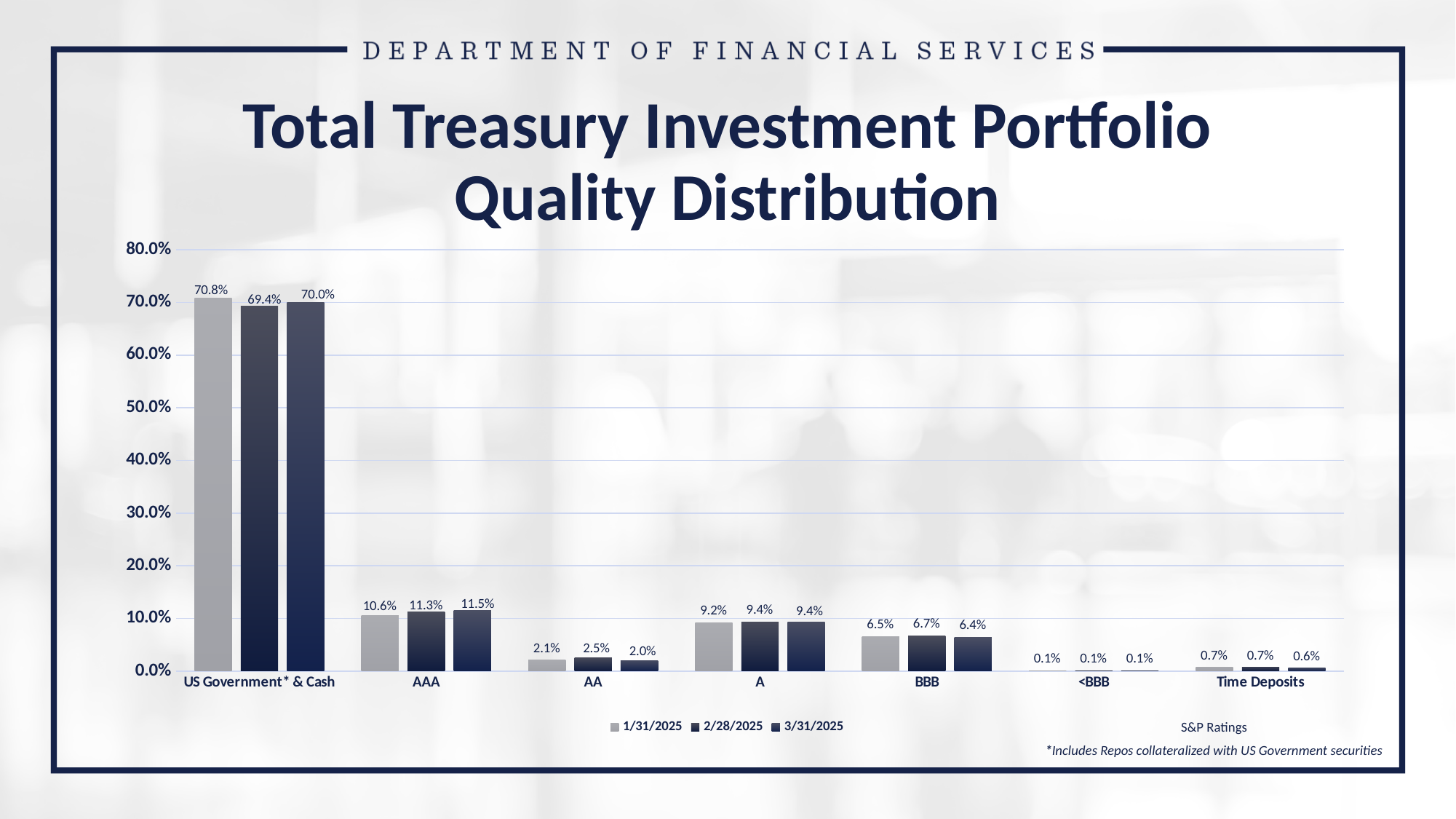
Which category has the highest value on 3/31/2025? US Government* & Cash What is the value for AAA on 3/31/2025? 11.5% Is the value for AAA on 1/31/2025 greater or less than 10.0%? greater What kind of chart is shown on the slide? Bar chart Which is larger for BBB: the 2/28/2025 value or the 3/31/2025 value? 2/28/2025 How many categories are shown on the x axis? 7 What is the value for AA on 2/28/2025? 2.5% Which category has the lowest value on 1/31/2025? <BBB What is the difference between the 1/31/2025 and 2/28/2025 values for US Government* & Cash? 1.4% What is the value for US Government* & Cash on 1/31/2025? 70.8% How many series does the legend list? 3 What is the value for Time Deposits on 3/31/2025? 0.6%